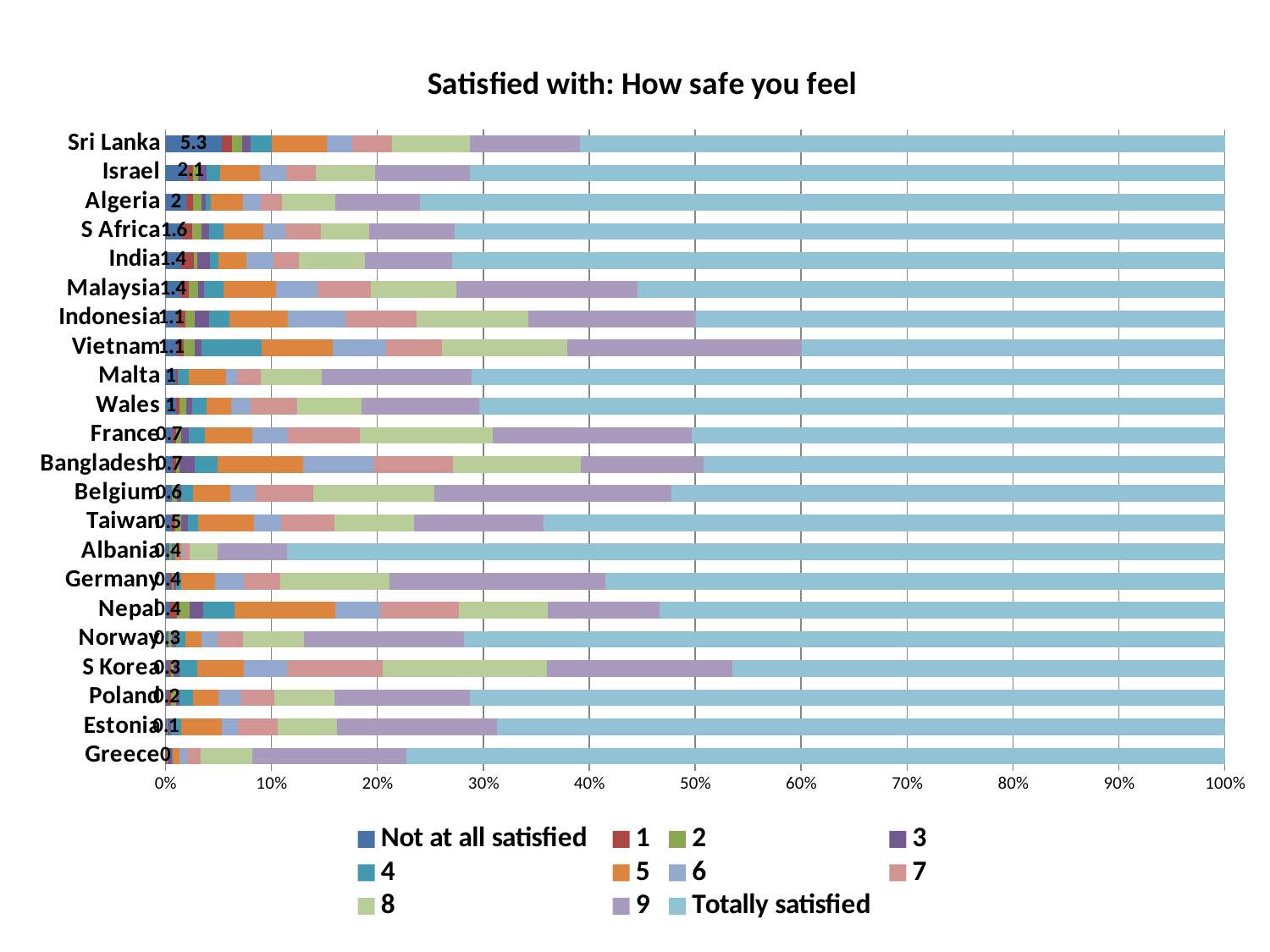
How many countries are shown on the chart? 22 Which has a larger 'Not at all satisfied' value, Algeria or Taiwan? Algeria How many series does the legend list? 11 What is the data label for the 'Not at all satisfied' series for Israel? 2.1 Which country has the lowest 'Not at all satisfied' value? Greece Is the 'Totally satisfied' share for Greece greater or less than 70%? greater What is the data label for the 'Not at all satisfied' series for Bangladesh? 0.7 What is the data label for the 'Not at all satisfied' series for Greece? 0 Which country has the highest 'Not at all satisfied' value? Sri Lanka What is the difference between the 'Not at all satisfied' values for Sri Lanka and Israel? 3.2 Is the 'Totally satisfied' share for Vietnam greater or less than 50%? less What is the data label for the 'Not at all satisfied' series for Sri Lanka? 5.3